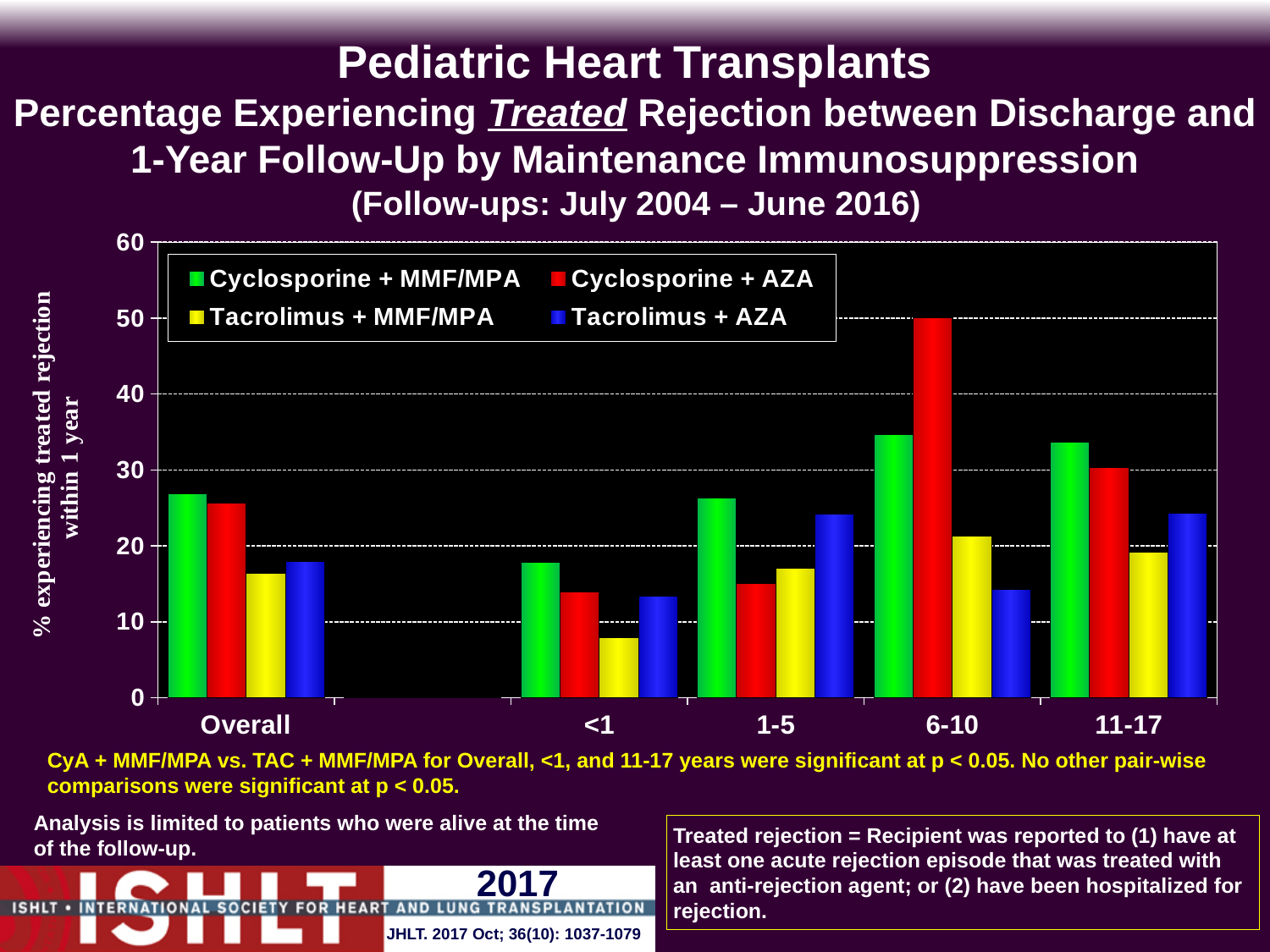
What colour represents Tacrolimus + AZA in the chart? blue Is the value for Cyclosporine + MMF/MPA in the 11-17 group greater or less than 30? greater How many age-group categories are shown along the x axis? 5 Is the value for Tacrolimus + MMF/MPA in the <1 group greater or less than 10? less How many series does the legend list? 4 What is the label on the y axis of the chart? % experiencing treated rejection within 1 year In the 1-5 group, which is larger: Tacrolimus + AZA or Cyclosporine + AZA? Tacrolimus + AZA In the 6-10 group, which is larger: Cyclosporine + AZA or Cyclosporine + MMF/MPA? Cyclosporine + AZA For which category is the Tacrolimus + MMF/MPA bar the lowest? <1 What kind of chart is shown on the slide? bar chart Is the value for Cyclosporine + AZA in the 6-10 group greater or less than 40? greater For which category is the Cyclosporine + AZA bar the highest? 6-10